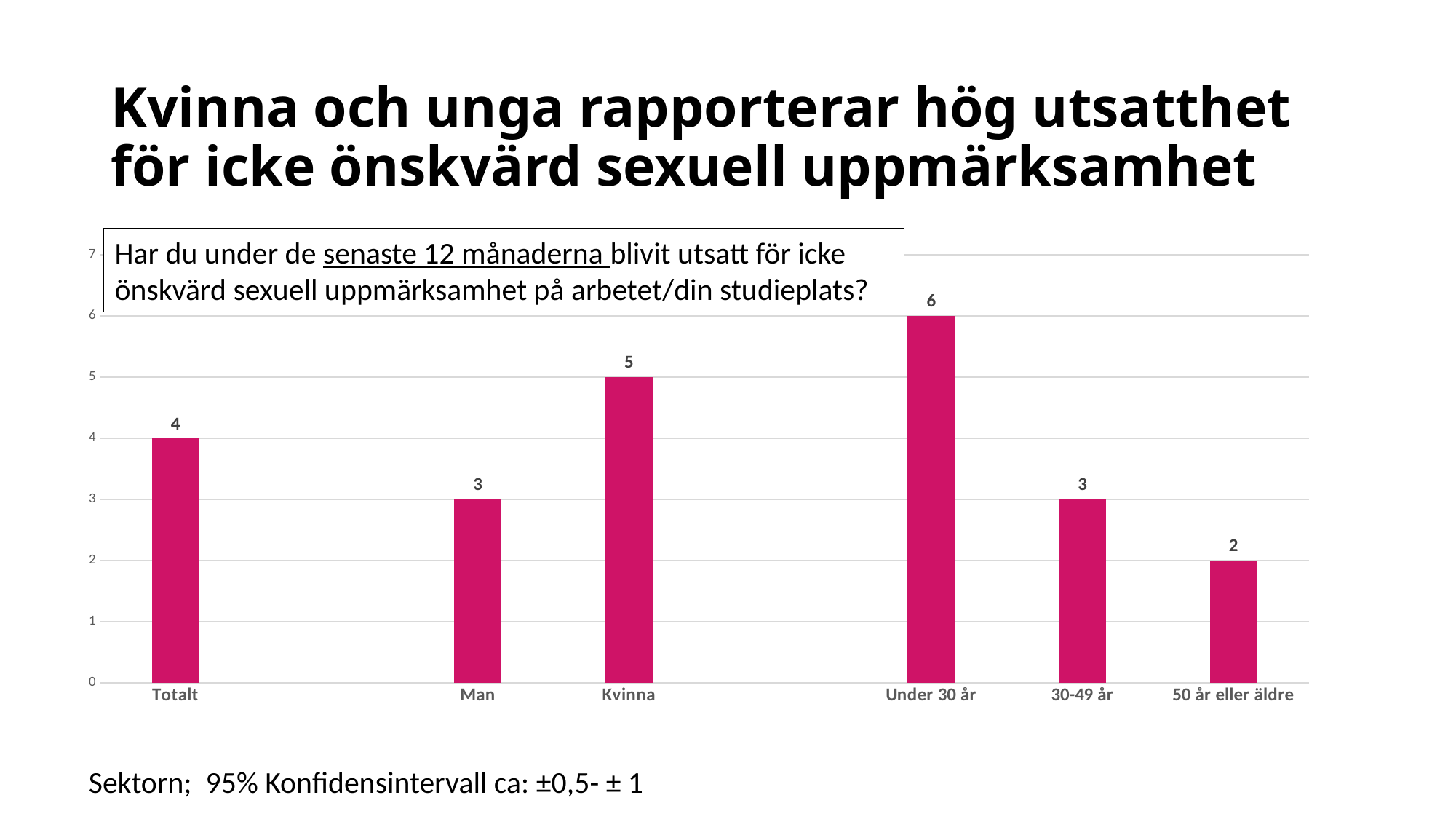
What colour are the bars in the chart? Magenta/pink What kind of chart is shown on the slide? Bar chart What is the value for 50 år eller äldre? 2 What is the value for Kvinna? 5 What is the value for Totalt? 4 Do the values fall or rise across the three age groups from Under 30 år to 50 år eller äldre? Fall How many categories are shown on the x axis? 6 Which category has the highest value? Under 30 år What is the difference between the values for Kvinna and Man? 2 Which is larger, the value for Under 30 år or the value for 30-49 år? Under 30 år What is the value for Under 30 år? 6 Which category has the lowest value? 50 år eller äldre